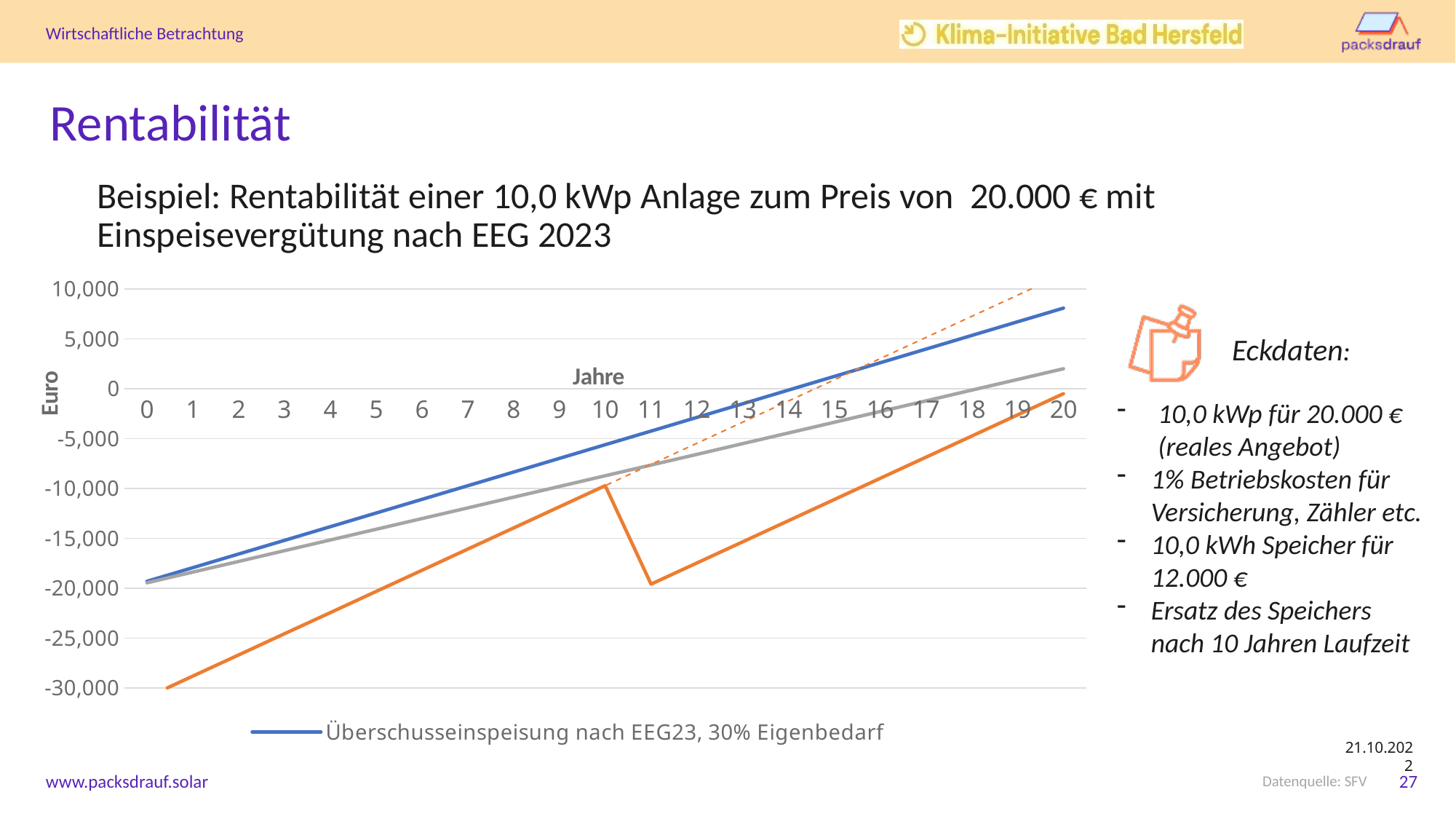
Is the value of the blue line (Überschusseinspeisung nach EEG23, 30% Eigenbedarf) at year 20 greater or less than 5,000? greater Is the value of the blue line (Überschusseinspeisung nach EEG23, 30% Eigenbedarf) at year 0 greater or less than -15,000? less At year 20, which line is higher: the blue line or the grey line? the blue line What is the title of the x axis of the chart? Jahre What kind of chart is shown on the slide? line chart Is the value of the solid orange line at year 0 greater or less than -25,000? less At year 0, which line is lower: the solid orange line or the blue line? the solid orange line What is the legend entry shown below the chart? Überschusseinspeisung nach EEG23, 30% Eigenbedarf Does the blue line (Überschusseinspeisung nach EEG23, 30% Eigenbedarf) rise or fall from year 0 to year 20? rises How many year values are labelled on the x axis of the chart? 21 How many series does the chart legend list? 1